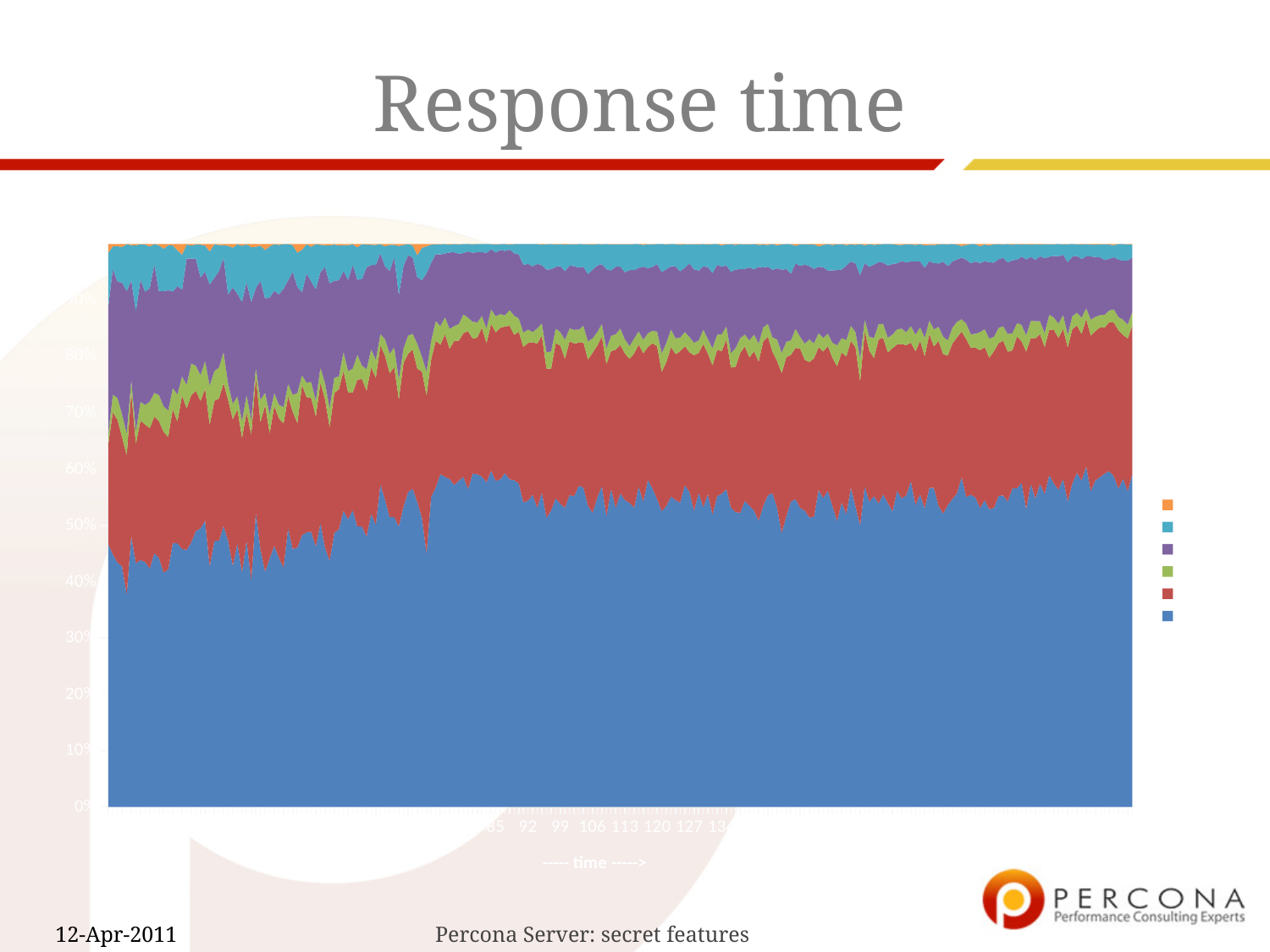
Does the share of the purple series rise or fall along the x axis? fall Which coloured series occupies the largest area of the chart? blue At the right end of the chart, is the top of the red area greater or less than 70%? greater What is the title of the chart? Response time How many series does the legend list? 6 Which coloured series occupies the smallest area of the chart? orange What is the label on the x axis of the chart? ----- time -----> Does the share of the blue series rise or fall along the x axis? rise At the left end of the chart, is the top of the red area greater or less than 80%? less At the right end of the chart, is the top of the blue area greater or less than 50%? greater What kind of chart is shown on the slide? stacked area chart